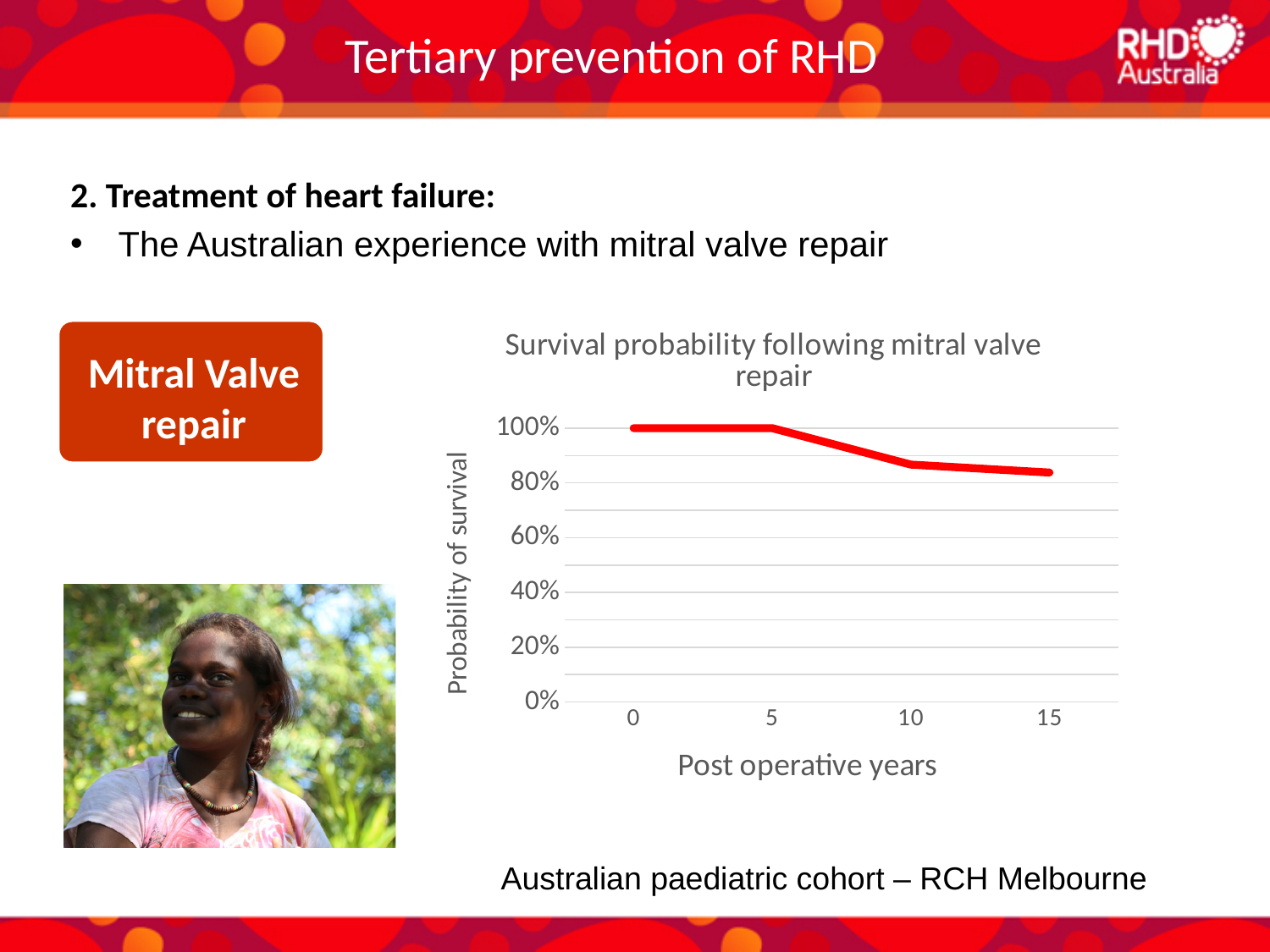
Is the probability of survival at 15 post operative years greater or less than 60%? greater What is the probability of survival at 5 post operative years? 100% Which is larger, the probability of survival at 5 post operative years or at 15 post operative years? 5 post operative years What is the label of the x axis of the chart? Post operative years How many post operative year points are plotted on the chart? 4 Is the probability of survival at 10 post operative years greater or less than 80%? greater What is the probability of survival at 0 post operative years? 100% Does the probability of survival rise or fall as post operative years increase? fall Is the probability of survival at 15 post operative years greater or less than 100%? less What is the title of the chart? Survival probability following mitral valve repair What kind of chart is shown on the slide? line chart